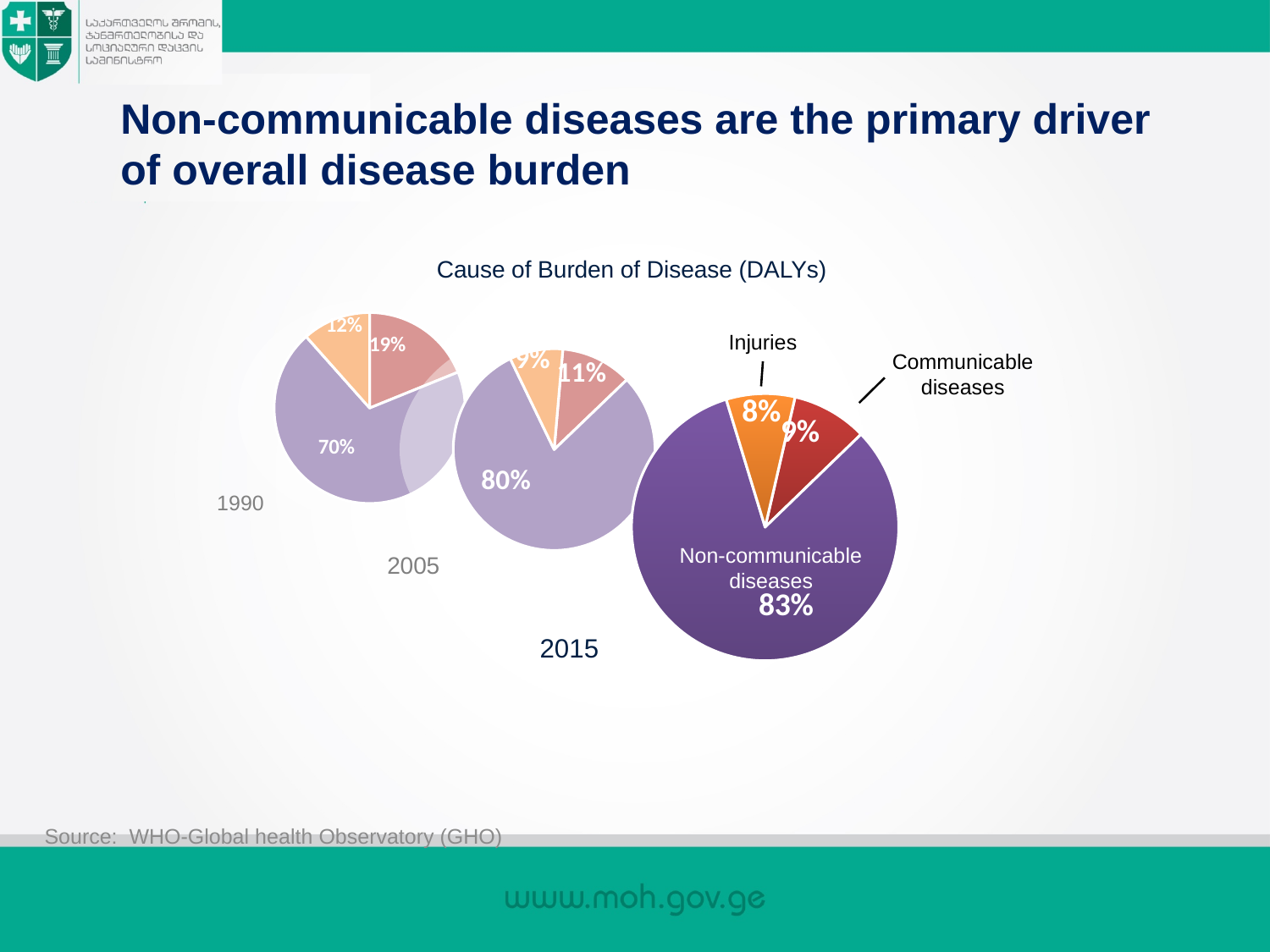
In the 1990 pie chart, what share is attributed to non-communicable diseases? 70% In the 2005 pie chart, what share is attributed to non-communicable diseases? 80% By how many percentage points did the non-communicable disease share increase from 1990 to 2015? 13 percentage points In the 2015 pie chart, what share is attributed to communicable diseases? 9% In the 2015 pie chart, which cause accounts for the largest share of the disease burden? Non-communicable diseases How does the share of non-communicable diseases change across the 1990, 2005 and 2015 pie charts? It rises In the 2015 pie chart, which cause accounts for the smallest share? Injuries What type of chart is used to show the cause of burden of disease on this slide? Pie chart In the 1990 pie chart, what share is attributed to communicable diseases? 19% In the 2015 pie chart, what share is attributed to injuries? 8% In the 2005 pie chart, what share is attributed to communicable diseases? 11% In the 2015 pie chart, what share of the burden of disease is attributed to non-communicable diseases? 83%